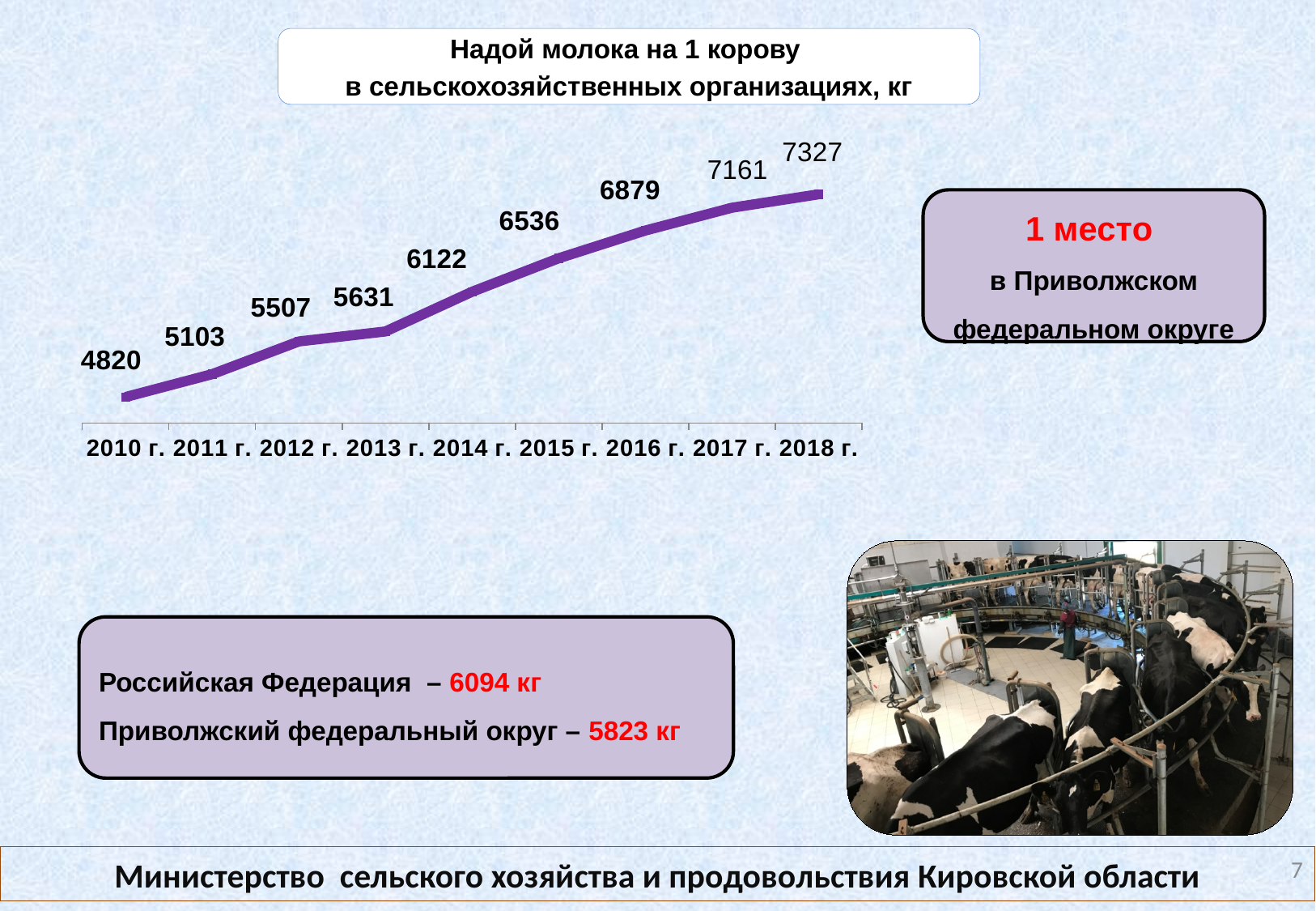
What is the milk yield per cow shown for 2010 г.? 4820 What is the difference between the values for 2018 г. and 2010 г.? 2507 Which is larger, the value for 2015 г. or the value for 2016 г.? 2016 г. What kind of chart is shown on the slide? line chart Do the values rise or fall from 2010 г. to 2018 г.? rise Which year has the highest value on the chart? 2018 г. What is the difference between the values for 2013 г. and 2012 г.? 124 How many years are plotted on the chart? 9 What value is plotted for 2014 г.? 6122 Which year has the lowest value on the chart? 2010 г. What is the title of the chart? Надой молока на 1 корову в сельскохозяйственных организациях, кг What value is plotted for 2018 г.? 7327